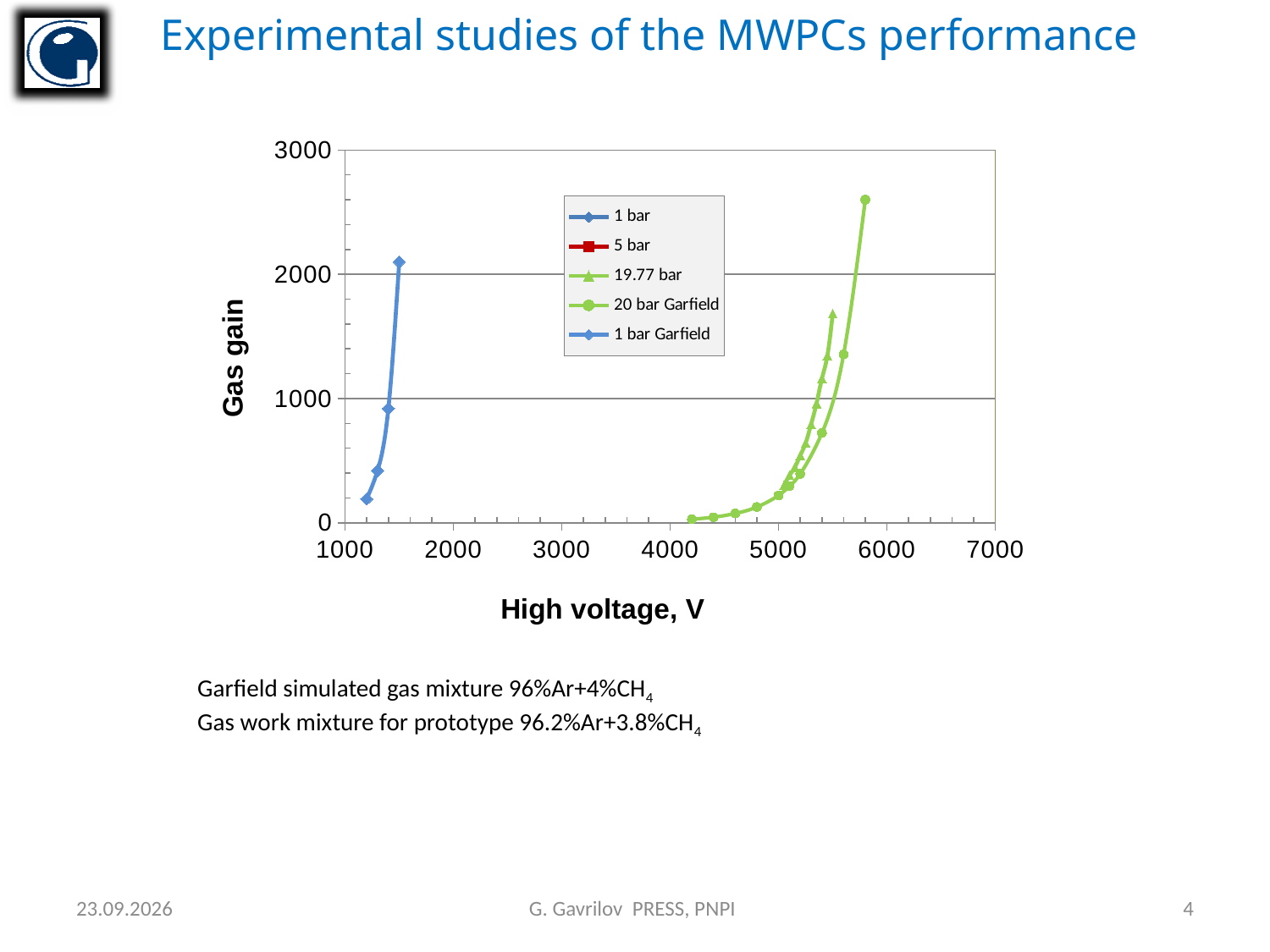
Which series reaches a gas gain above 1000 at the lowest high voltage, 1 bar or 19.77 bar? 1 bar Which series reaches the highest gas gain on the chart? 20 bar Garfield Is the highest gas gain value of the 19.77 bar series greater or less than 1000? greater What is the label of the x axis? High voltage, V Is the highest gas gain value of the 19.77 bar series greater or less than 2000? less How many series does the legend list? 5 Is the highest gas gain value of the 1 bar series greater or less than 1000? greater Does the gas gain rise or fall as the high voltage increases along the x axis? Rise What is the label of the y axis? Gas gain Which series reaches a higher maximum gas gain, 20 bar Garfield or 19.77 bar? 20 bar Garfield What kind of chart is shown on the slide? Line chart